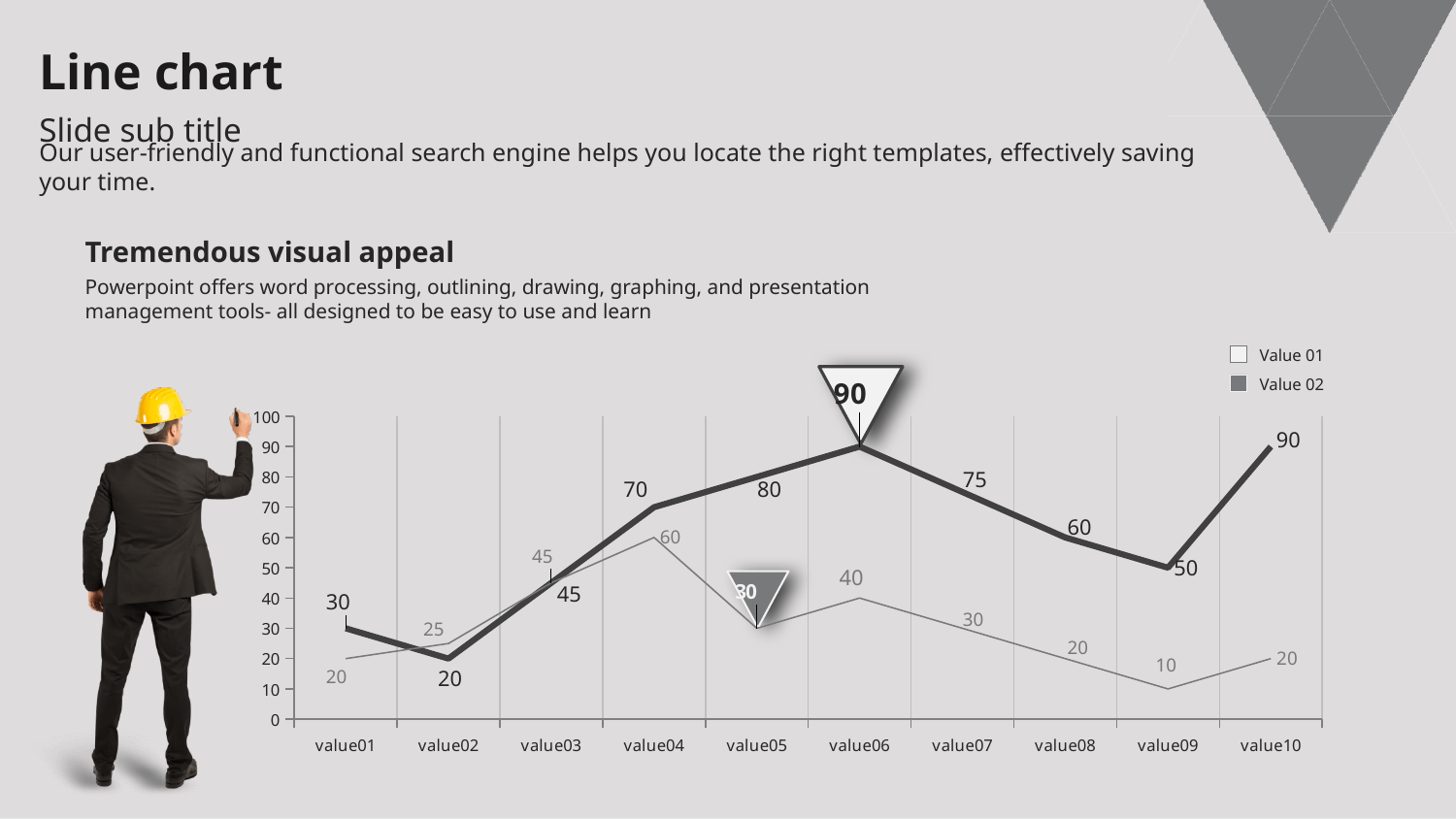
What is the value of Value 02 at value09? 50 What is the difference between Value 02 and Value 01 at value06? 50 Which series has the larger value at value02, Value 01 or Value 02? Value 01 What is the value of Value 02 at value06? 90 How many series does the legend list? 2 At which category does Value 01 reach its highest value? value04 How many categories are plotted along the x axis? 10 Does Value 02 rise or fall from value06 to value09? fall What is the value of Value 01 at value04? 60 What kind of chart is shown on the slide? line chart At which category does Value 02 reach its lowest value? value02 At which category does Value 01 reach its lowest value? value09